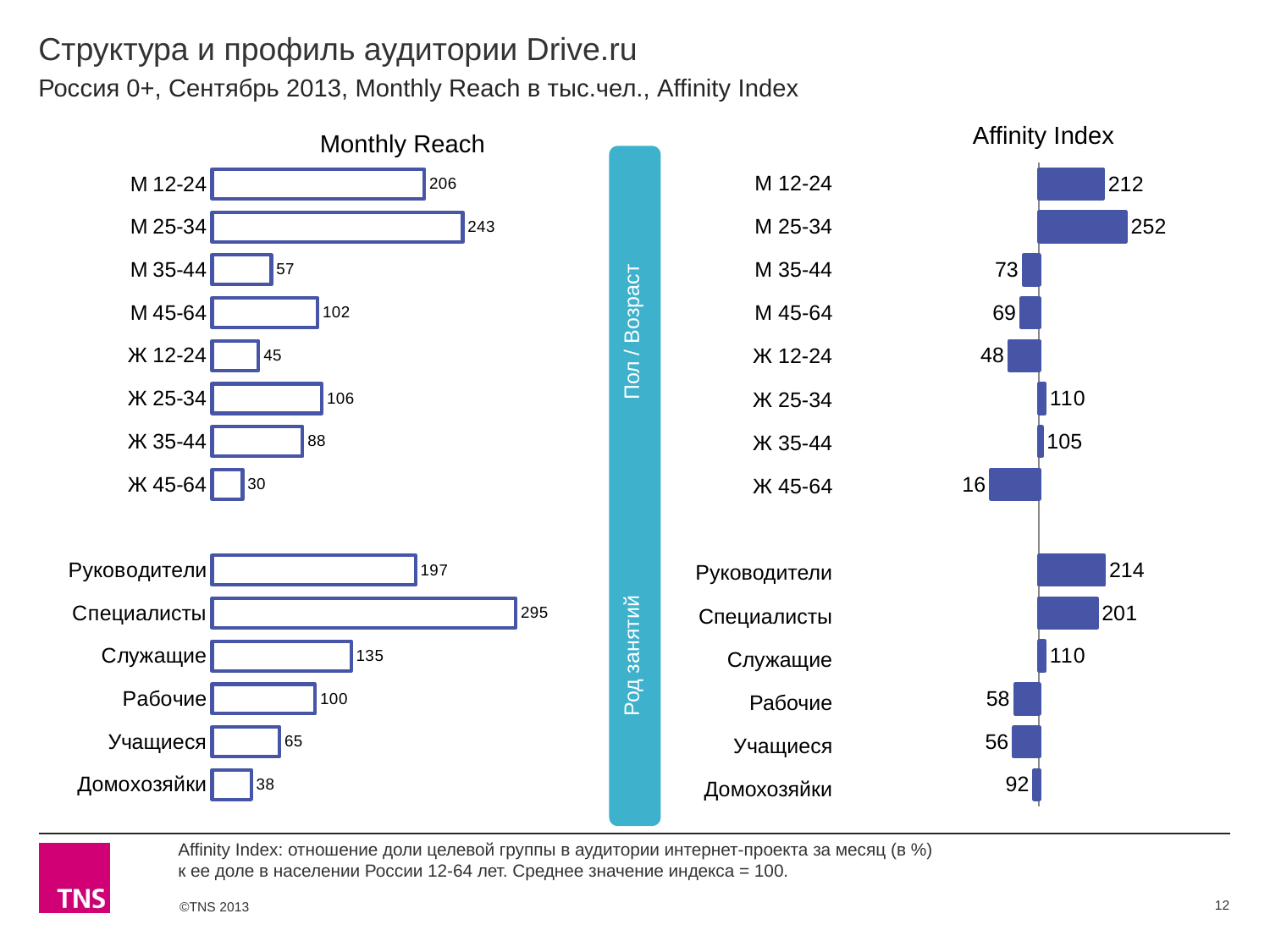
In the Affinity Index chart, which is larger: М 12-24 or Руководители? Руководители In the Monthly Reach chart, what is the value for М 25-34? 243 In the Monthly Reach chart, what is the difference between Руководители and Служащие? 62 In the Monthly Reach chart, what is the value for Домохозяйки? 38 In the Monthly Reach chart, which category has the highest value? Специалисты In the Affinity Index chart, what is the value for Ж 45-64? 16 What kind of chart is the Monthly Reach chart? Bar chart In the Affinity Index chart, which category has the lowest value? Ж 45-64 In the Affinity Index chart, what is the difference between М 25-34 and М 35-44? 179 In the Monthly Reach chart, which is larger: Ж 25-34 or М 45-64? Ж 25-34 What are the two group labels shown on the vertical band between the charts? Пол / Возраст and Род занятий How many categories are plotted in the Affinity Index chart? 14